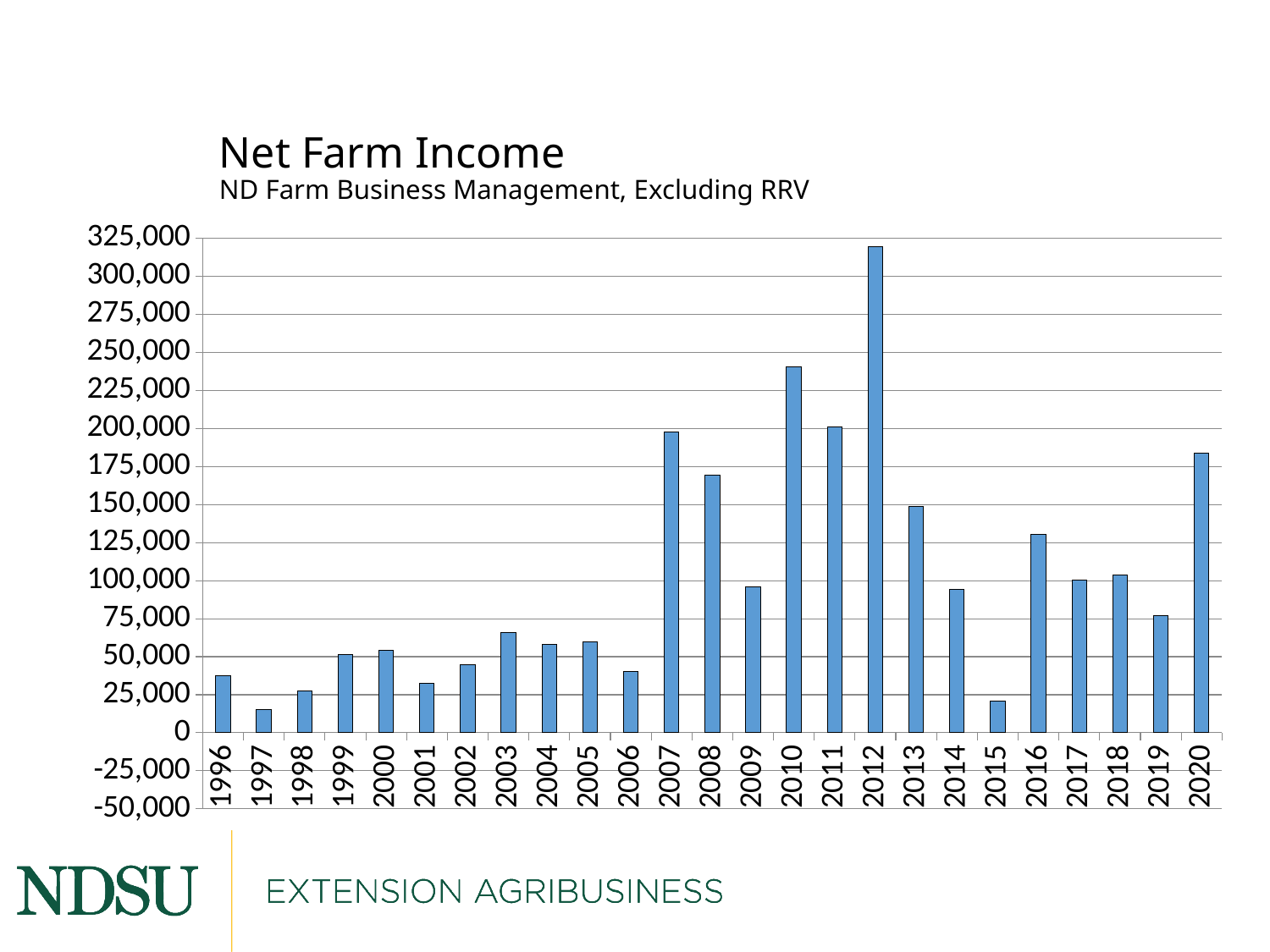
How many years are plotted on the x axis of the Net Farm Income chart? 25 What kind of chart is shown on the slide? Bar chart Which year has the larger net farm income, 2008 or 2013? 2008 What is the subtitle shown under the chart title 'Net Farm Income'? ND Farm Business Management, Excluding RRV Is the value for 2010 greater or less than 225,000? greater Is the value for 2006 greater or less than 50,000? less Is the value for 2012 greater or less than 300,000? greater Do the values rise or fall from 2012 to 2015? fall Which year has the larger net farm income, 2010 or 2011? 2010 Which year has the highest net farm income? 2012